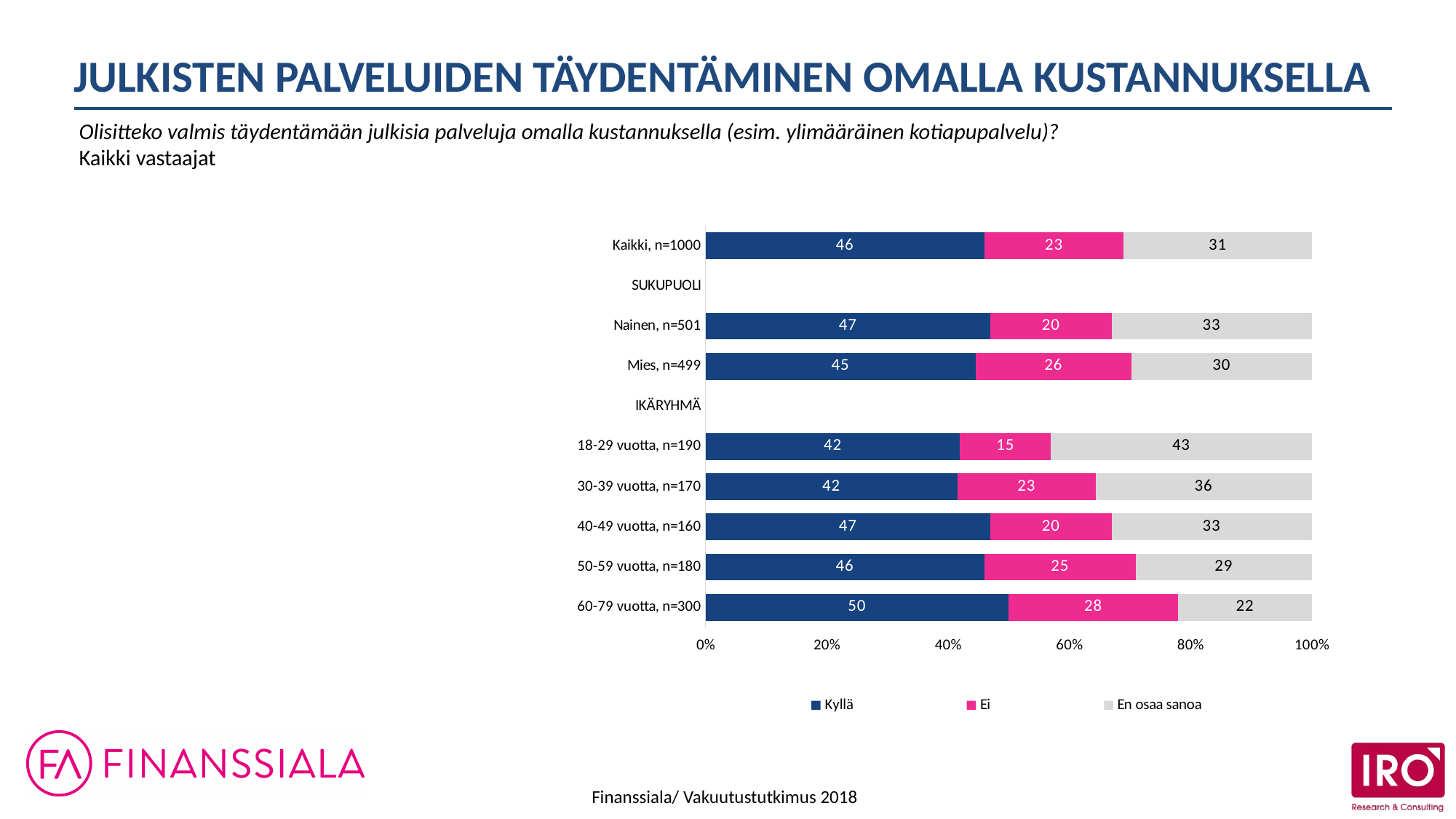
What is the difference between the Kyllä values for Nainen, n=501 and Mies, n=499? 2 Which category has the lowest Ei value? 18-29 vuotta, n=190 What is the En osaa sanoa value for 18-29 vuotta, n=190? 43 What is the total of the stacked bar for 60-79 vuotta, n=300? 100 Which is larger, the En osaa sanoa value for 30-39 vuotta, n=170 or for 50-59 vuotta, n=180? 30-39 vuotta, n=170 How many series does the legend list? 3 How many categories with data bars are plotted in the chart? 8 Which legend entry is shown in pink? Ei What is the Kyllä value for Kaikki, n=1000? 46 Which category has the highest Kyllä value? 60-79 vuotta, n=300 What is the Ei value for Mies, n=499? 26 What kind of chart is shown on the slide? Stacked bar chart